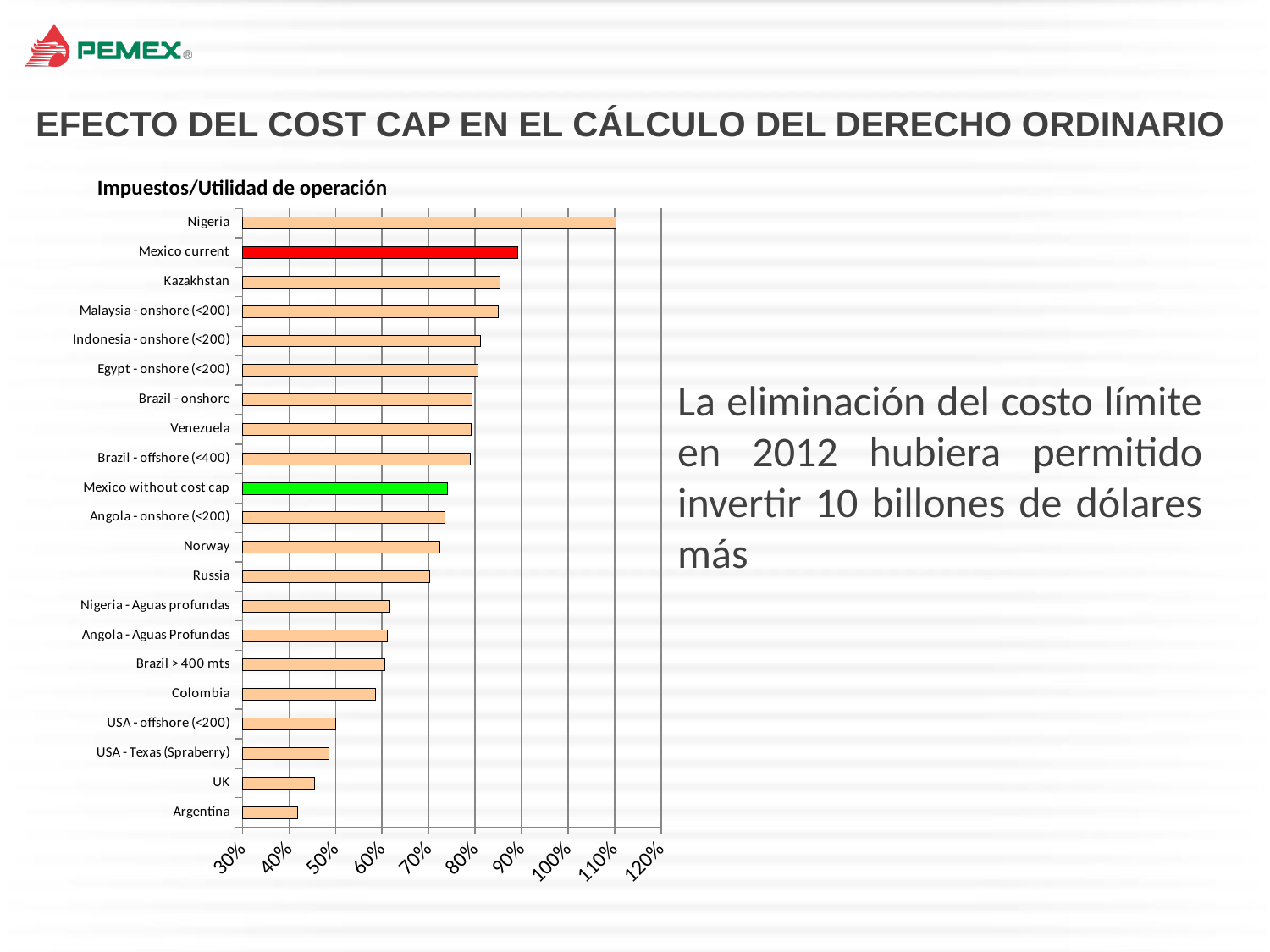
Which is larger, the value for Norway or the value for UK? Norway Which is larger, the value for Mexico current or the value for Mexico without cost cap? Mexico current Is the value for Colombia greater or less than 50%? greater How many categories are plotted in the chart? 21 Is the value for Mexico without cost cap greater or less than 80%? less Which category has the lowest value in the chart? Argentina Is the value for Mexico current greater or less than 80%? greater Which category has the highest value in the chart? Nigeria What kind of chart is shown on the slide? bar chart What is the title of the chart? Impuestos/Utilidad de operación